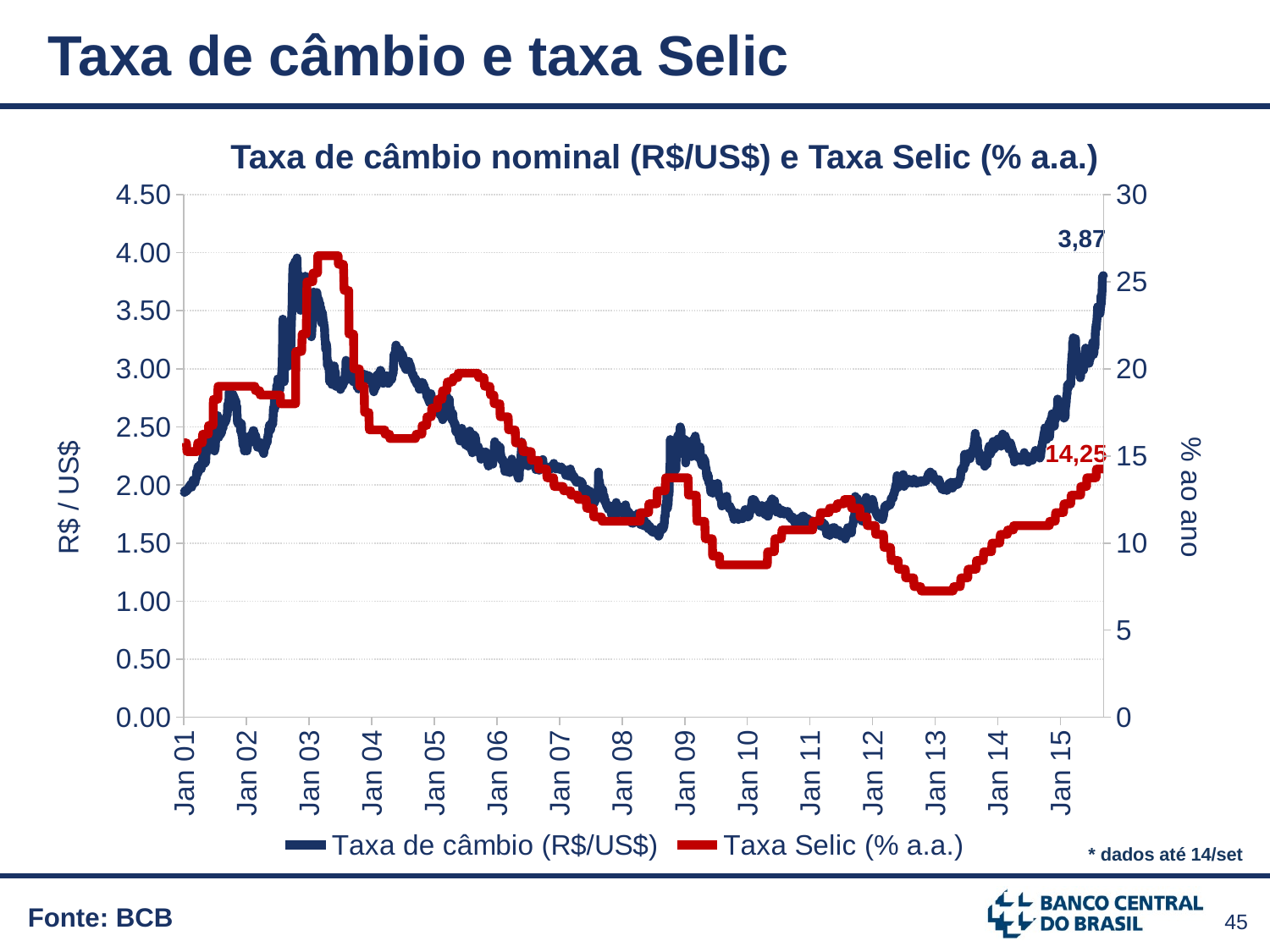
What is the latest labelled value of the Taxa Selic (% a.a.) series? 14,25 How many year labels are shown on the x axis? 15 Is the Taxa Selic value at Jan 13 greater or less than 10? less What is the title of the chart? Taxa de câmbio nominal (R$/US$) e Taxa Selic (% a.a.) Does the Taxa Selic series rise or fall between Jan 13 and Jan 15? rise Is the Taxa Selic value at Jan 03 greater or less than 20? greater What kind of chart is shown on the slide? line chart Is the Taxa de câmbio value at Jan 09 greater or less than 2.00? greater Does the Taxa de câmbio series rise or fall between Jan 03 and Jan 08? fall How many series does the legend list? 2 What is the latest labelled value of the Taxa de câmbio (R$/US$) series? 3,87